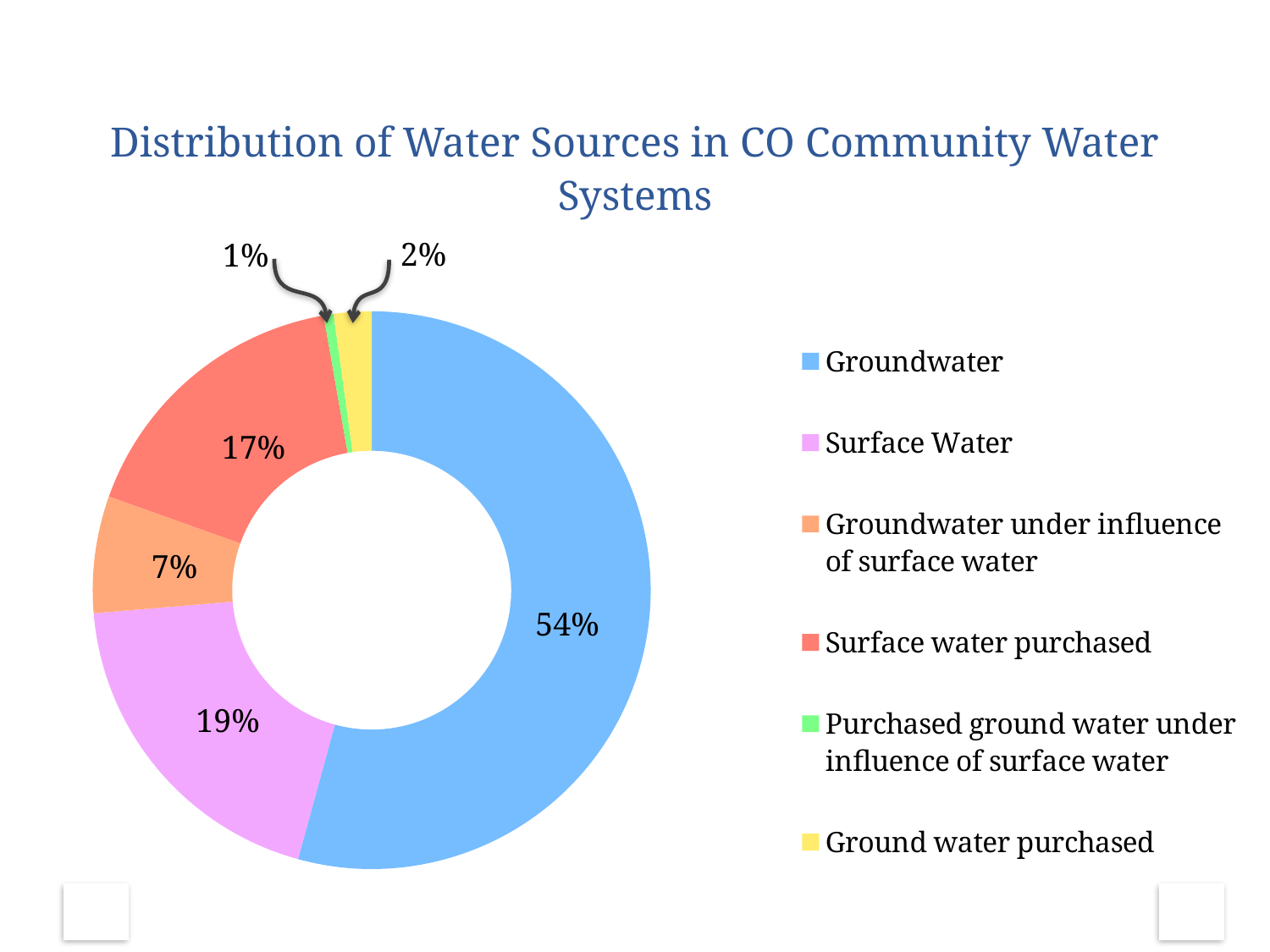
What is the value shown for Groundwater under influence of surface water? 7% What share of the pie does Groundwater represent? 54% How many categories does the chart show? 6 What is the difference between the Groundwater share and the Surface Water share? 35% What is the value shown for Surface water purchased? 17% Which is larger, Surface Water or Surface water purchased? Surface Water What is the title of the chart? Distribution of Water Sources in CO Community Water Systems What is the value shown for Ground water purchased? 2% Which water source has the smallest share? Purchased ground water under influence of surface water Which water source has the largest share? Groundwater What is the value shown for Surface Water? 19% What kind of chart is shown on the slide? Pie chart (doughnut)